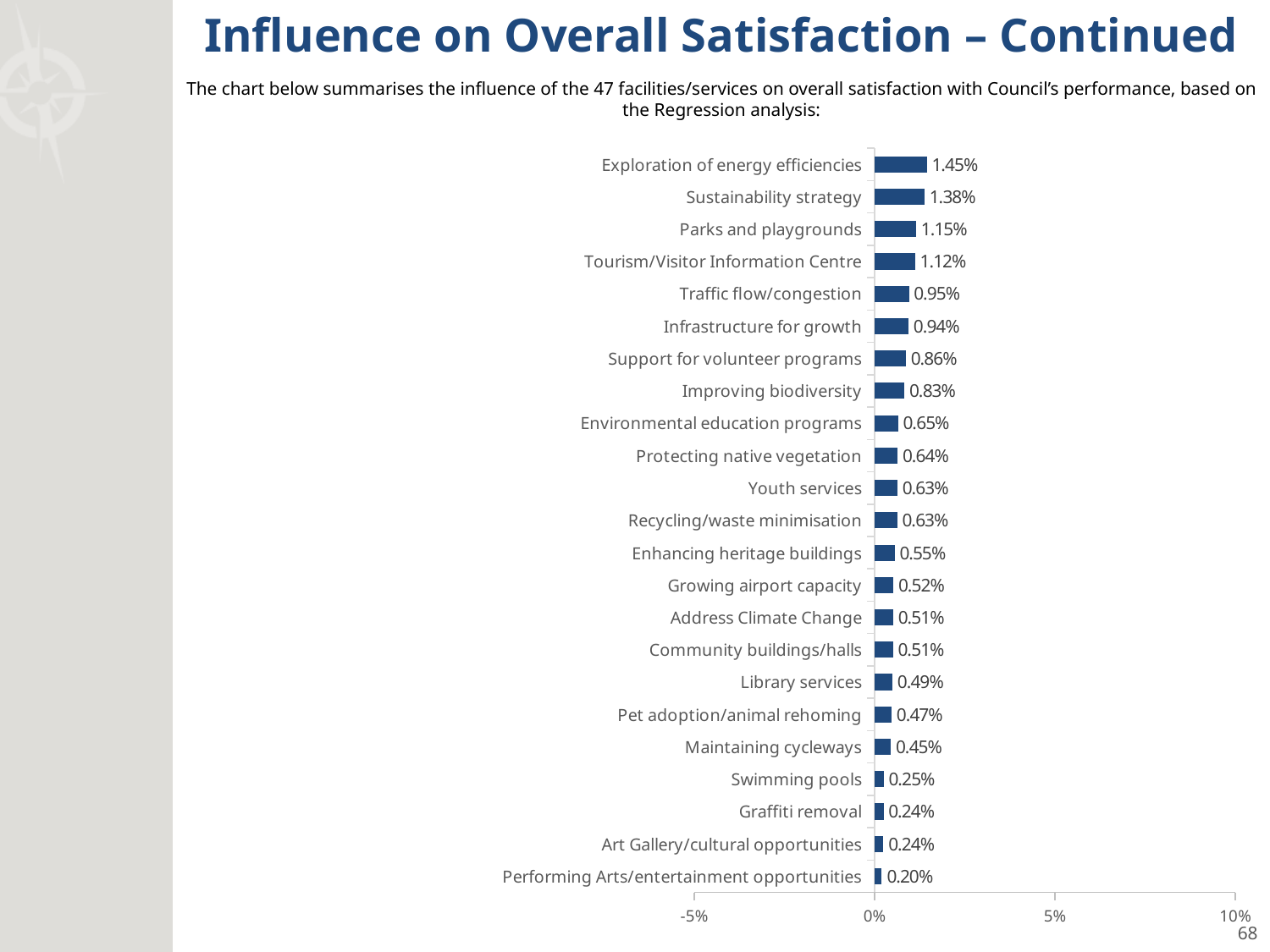
What is the value for Swimming pools? 0.25% What kind of chart is shown on the slide? bar chart Which category has the lowest value? Performing Arts/entertainment opportunities What is the value for Library services? 0.49% What is the value for Exploration of energy efficiencies? 1.45% How many categories are shown in the chart? 23 Which category has the highest value? Exploration of energy efficiencies Which is larger, the value for Parks and playgrounds or the value for Tourism/Visitor Information Centre? Parks and playgrounds What is the difference between the values for Exploration of energy efficiencies and Sustainability strategy? 0.07% What is the value for Traffic flow/congestion? 0.95% What is the difference between the values for Exploration of energy efficiencies and Performing Arts/entertainment opportunities? 1.25% Is the value for Sustainability strategy greater or less than 5%? less